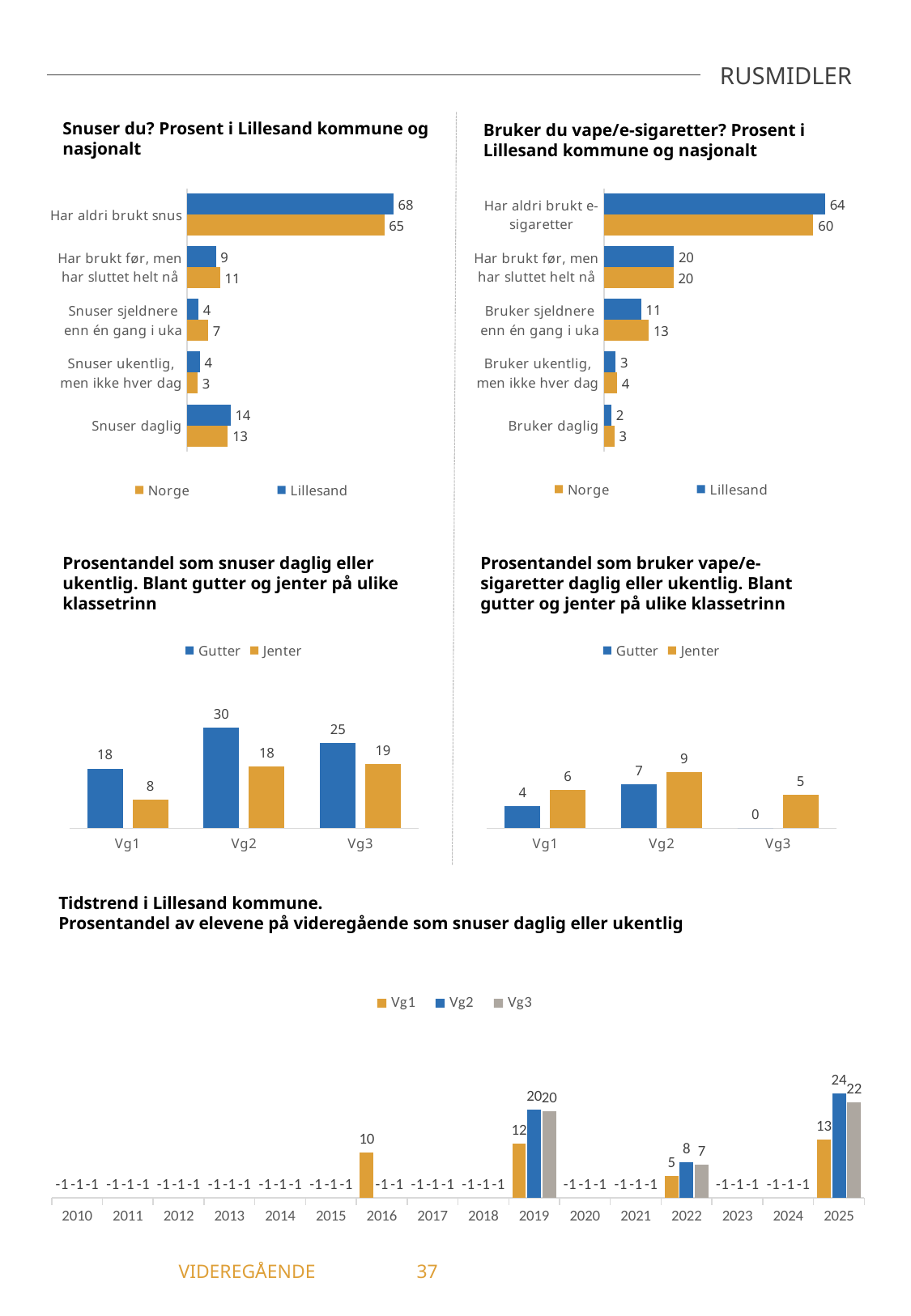
In the chart 'Bruker du vape/e-sigaretter? Prosent i Lillesand kommune og nasjonalt', how many categories are shown? 5 In the chart 'Bruker du vape/e-sigaretter? Prosent i Lillesand kommune og nasjonalt', what is the value for Norge for 'Bruker sjeldnere enn én gang i uka'? 13 In the chart 'Prosentandel som bruker vape/e-sigaretter daglig eller ukentlig. Blant gutter og jenter på ulike klassetrinn', what is the value for Gutter at Vg3? 0 In the chart 'Prosentandel som bruker vape/e-sigaretter daglig eller ukentlig. Blant gutter og jenter på ulike klassetrinn', which class level has the highest Jenter value? Vg2 In the chart 'Snuser du? Prosent i Lillesand kommune og nasjonalt', what is the difference between the Norge and Lillesand values for 'Har brukt før, men har sluttet helt nå'? 2 What kind of chart is 'Tidstrend i Lillesand kommune'? Bar chart In the chart 'Prosentandel som snuser daglig eller ukentlig. Blant gutter og jenter på ulike klassetrinn', what is the value for Gutter at Vg2? 30 In the chart 'Prosentandel som snuser daglig eller ukentlig. Blant gutter og jenter på ulike klassetrinn', which is larger at Vg1, Gutter or Jenter? Gutter In the chart 'Bruker du vape/e-sigaretter? Prosent i Lillesand kommune og nasjonalt', which category has the lowest Lillesand value? Bruker daglig In the chart 'Tidstrend i Lillesand kommune', how many series does the legend list? 3 In the chart 'Snuser du? Prosent i Lillesand kommune og nasjonalt', what is the value for Lillesand for 'Har aldri brukt snus'? 68 In the chart 'Tidstrend i Lillesand kommune', what is the value for Vg2 in 2025? 24